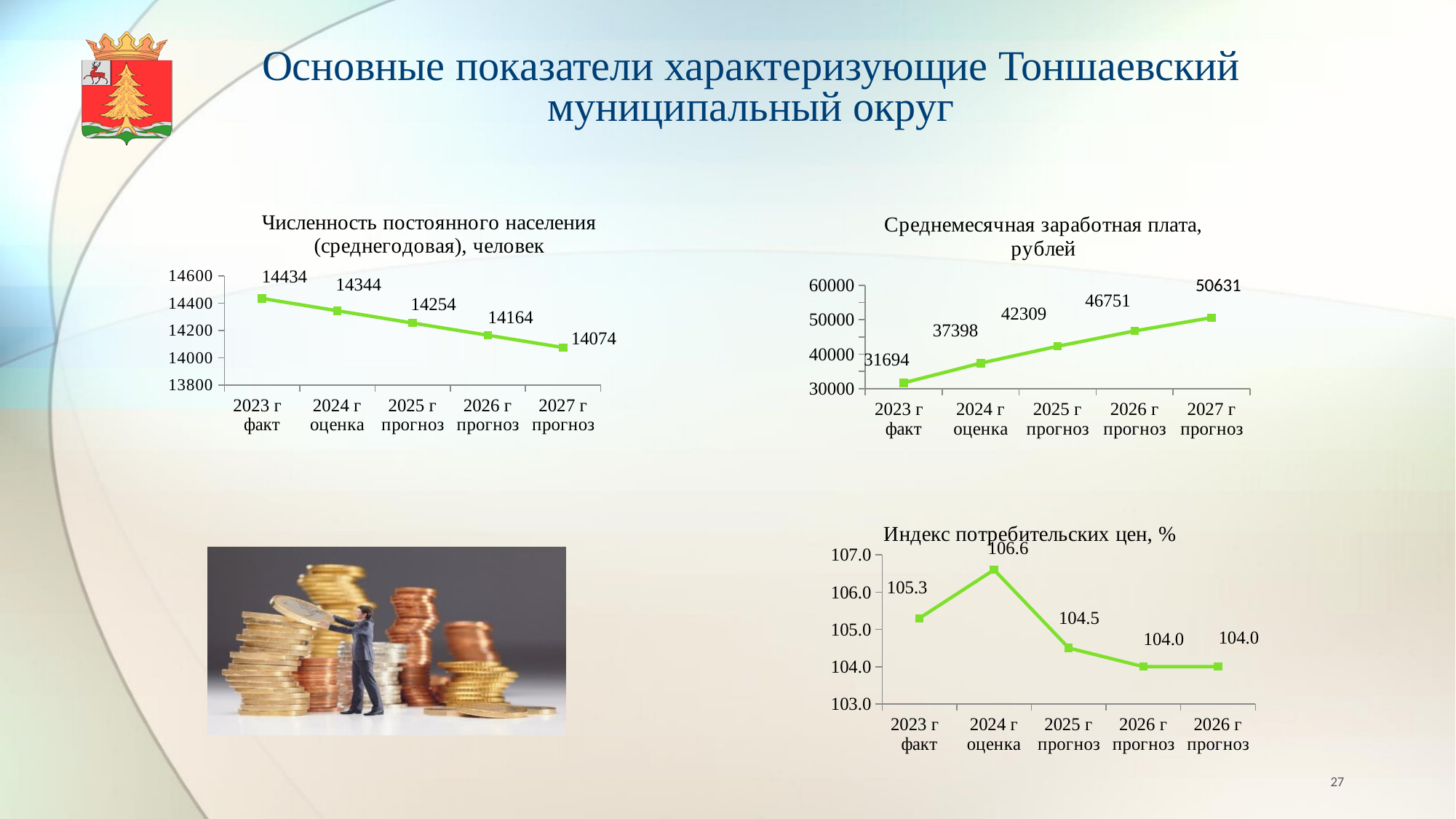
In the chart 'Среднемесячная заработная плата, рублей', what is the difference between the 2024 г оценка value and the 2023 г факт value? 5704 In the chart 'Индекс потребительских цен, %', what is the value for 2024 г оценка? 106.6 What kind of chart is 'Индекс потребительских цен, %'? line chart In the chart 'Среднемесячная заработная плата, рублей', how many data points are plotted? 5 In the chart 'Численность постоянного населения (среднегодовая), человек', do the values rise or fall from 2023 to 2027? fall In the chart 'Индекс потребительских цен, %', is the value for 2023 г факт larger or smaller than the value for 2025 г прогноз? larger In the chart 'Среднемесячная заработная плата, рублей', which year has the highest value? 2027 г прогноз In the chart 'Индекс потребительских цен, %', which year has the highest value? 2024 г оценка In the chart 'Численность постоянного населения (среднегодовая), человек', what is the difference between the 2023 г факт value and the 2027 г прогноз value? 360 In the chart 'Численность постоянного населения (среднегодовая), человек', what is the value for 2027 г прогноз? 14074 In the chart 'Численность постоянного населения (среднегодовая), человек', what is the value for 2023 г факт? 14434 In the chart 'Среднемесячная заработная плата, рублей', what is the value for 2025 г прогноз? 42309